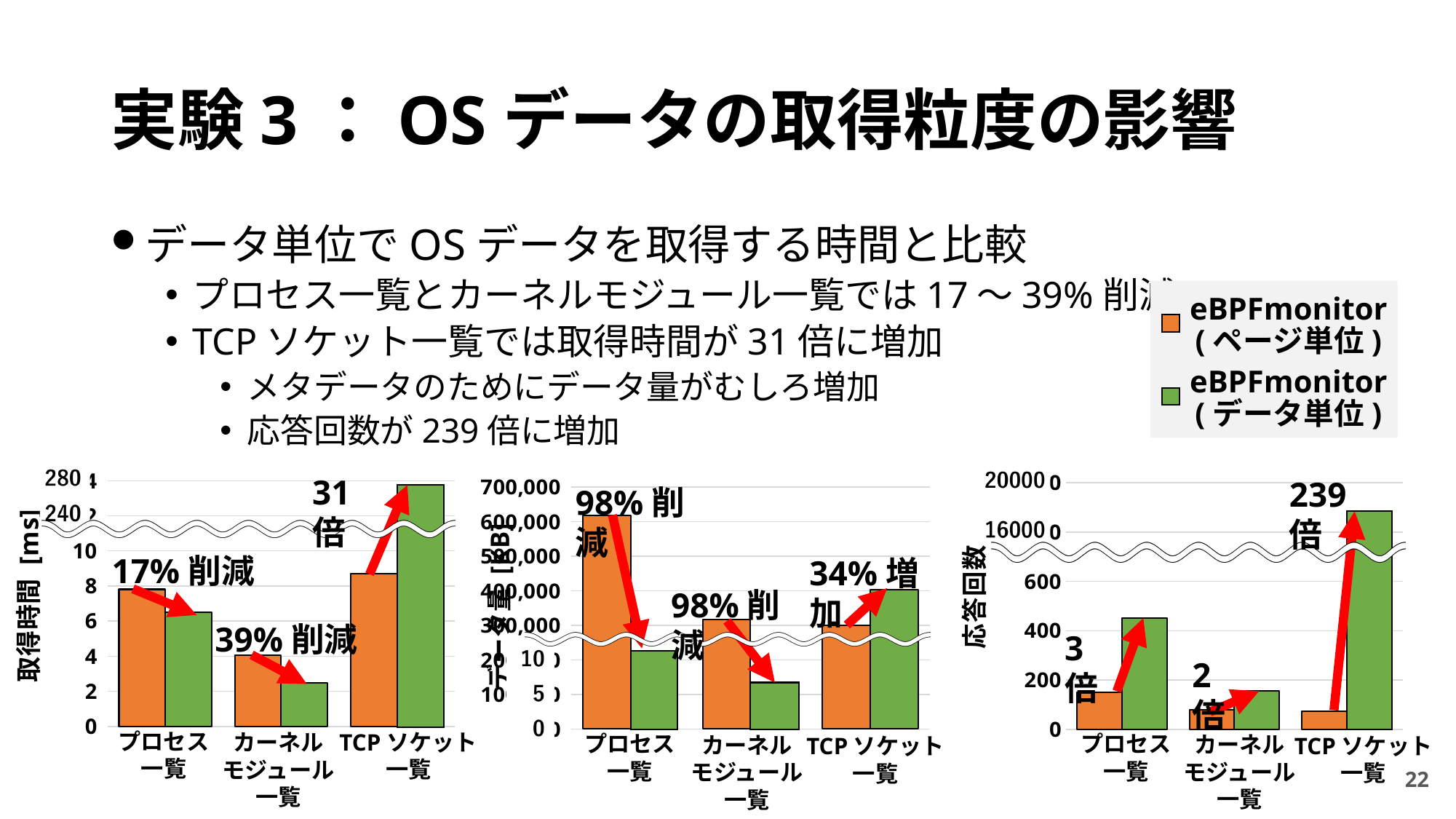
In the right chart (応答回数), is the eBPFmonitor (データ単位) value for プロセス一覧 greater or less than 400? greater What kind of chart is the left chart (取得時間 [ms])? bar chart How many categories are shown on the x axis of the left chart (取得時間 [ms])? 3 Which colour represents eBPFmonitor (データ単位) in the legend? green How many series does the legend list for the charts on this slide? 2 In the left chart (取得時間 [ms]), is the eBPFmonitor (ページ単位) value for プロセス一覧 greater or less than 6? greater In the right chart (応答回数), which category has the lowest value for eBPFmonitor (データ単位)? カーネルモジュール一覧 In the middle chart (データ量 [B]), which category has the highest value for eBPFmonitor (ページ単位)? プロセス一覧 In the middle chart (データ量 [B]), is the eBPFmonitor (ページ単位) value for プロセス一覧 greater or less than 500,000? greater In the left chart (取得時間 [ms]), which category has the highest value for eBPFmonitor (データ単位)? TCP ソケット一覧 In the left chart (取得時間 [ms]), which is larger for カーネルモジュール一覧: eBPFmonitor (ページ単位) or eBPFmonitor (データ単位)? eBPFmonitor (ページ単位) In the middle chart (データ量 [B]), which is larger for TCP ソケット一覧: eBPFmonitor (ページ単位) or eBPFmonitor (データ単位)? eBPFmonitor (データ単位)